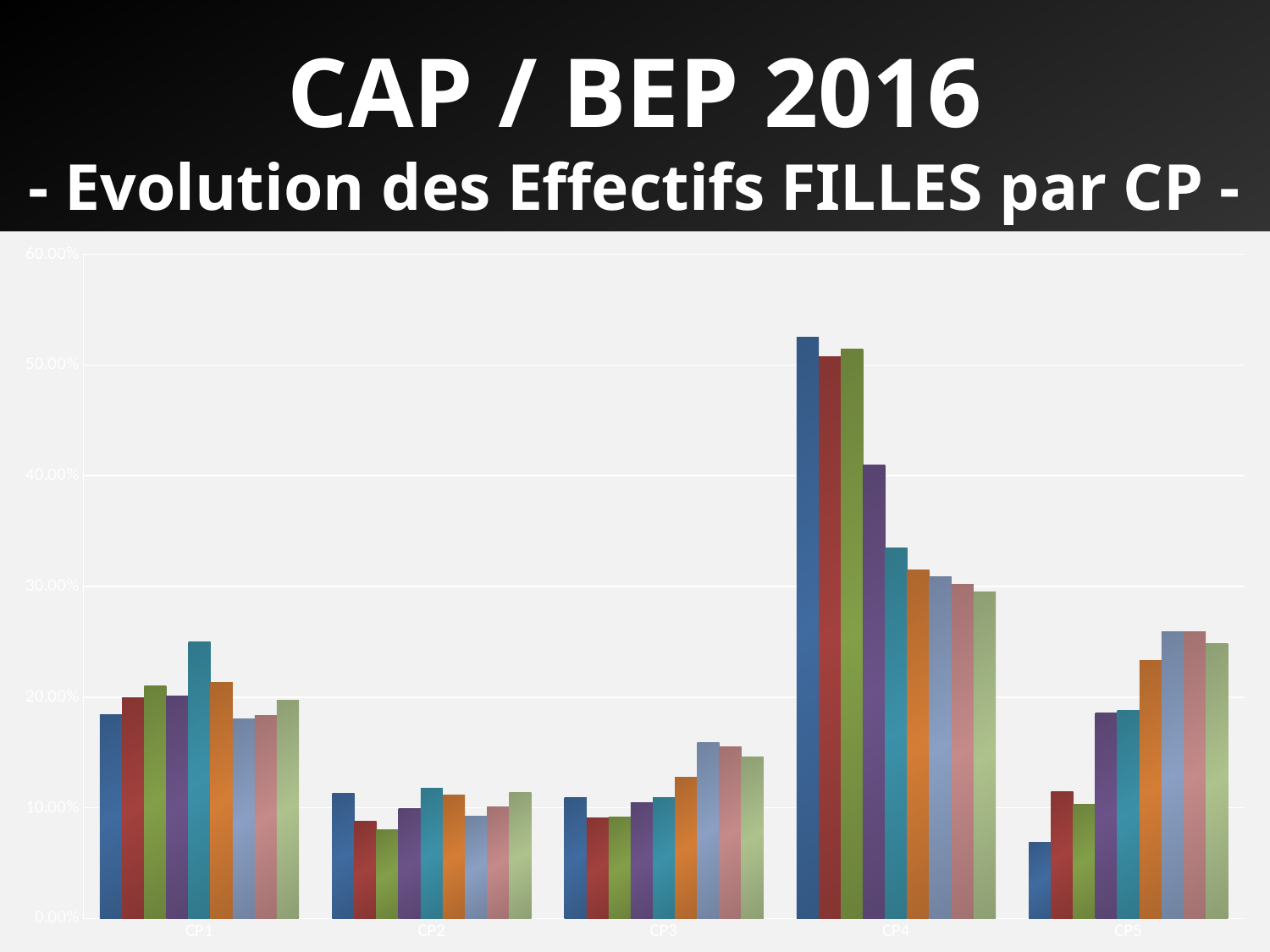
Within the CP4 group, do the bars generally rise or fall from left to right? fall Is the tallest bar in CP1 greater or less than 30%? less Is the tallest bar in CP5 greater or less than 20%? greater How many categories are shown on the x axis of the chart? 5 What is the subtitle written above the chart? - Evolution des Effectifs FILLES par CP - Which category has the taller bars overall, CP4 or CP2? CP4 How many bars are plotted for each category in the chart? 9 Which category contains the tallest bar in the chart? CP4 What is the highest value shown on the vertical axis of the chart? 60.00% Is the tallest bar in CP4 greater or less than 50%? greater What kind of chart is shown on the slide? bar chart